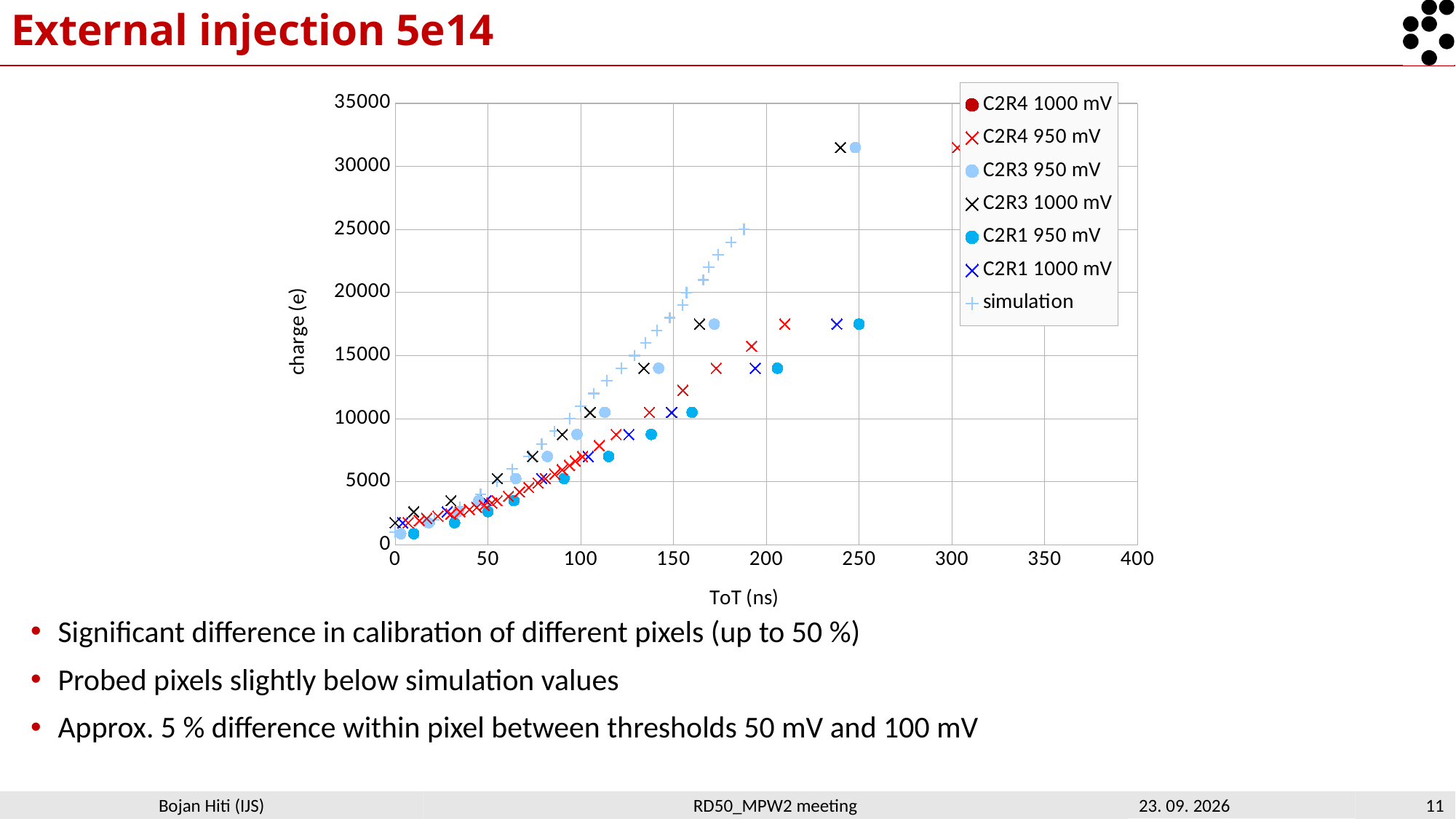
What kind of chart is shown on the slide? scatter chart What is the maximum value shown on the y axis of the chart? 35000 Is the largest ToT value reached by the C2R4 950 mV series greater or less than 250? greater How many series does the chart legend list? 7 Does the charge rise or fall as ToT increases along the x axis? rise Is the highest charge value of the C2R3 1000 mV series greater or less than 30000? greater What is the label of the y axis of the chart? charge (e) What is the label of the x axis of the chart? ToT (ns) Which series reaches the largest ToT value on the x axis? C2R4 950 mV At a ToT of about 250 ns, which series has the higher charge: C2R3 950 mV or C2R1 950 mV? C2R3 950 mV Is the highest charge value of the simulation series greater or less than 20000? greater